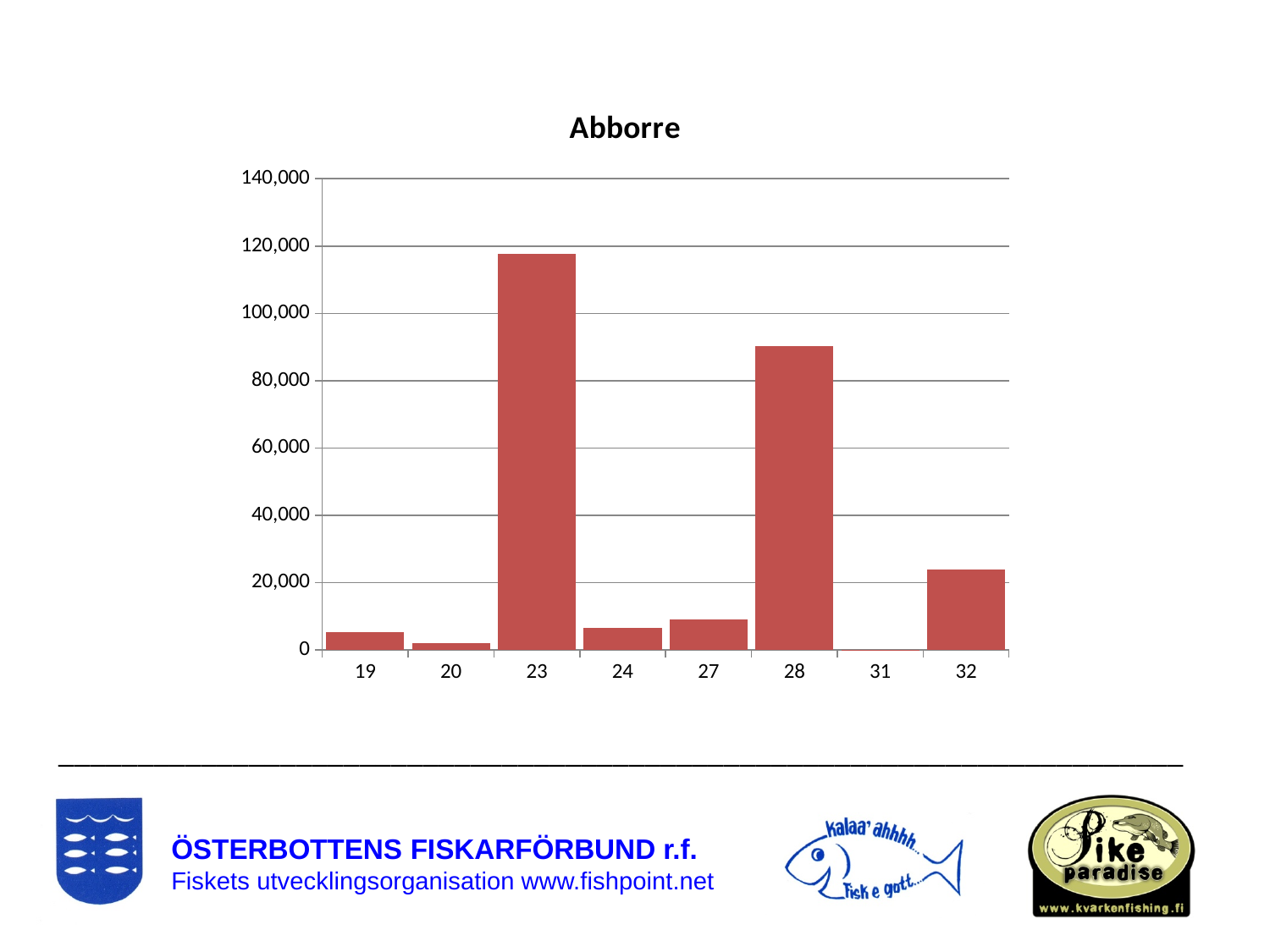
Which has the larger value, category 23 or category 28? 23 What kind of chart is shown on the slide? bar chart What is the title of the chart? Abborre Is the value for category 19 greater or less than 20,000? less Which has the larger value, category 32 or category 24? 32 Is the value for category 23 greater or less than 100,000? greater Which category has the lowest value in the chart? 31 Which category has the highest value in the chart? 23 Is the value for category 28 greater or less than 80,000? greater How many categories are shown on the x axis of the chart? 8